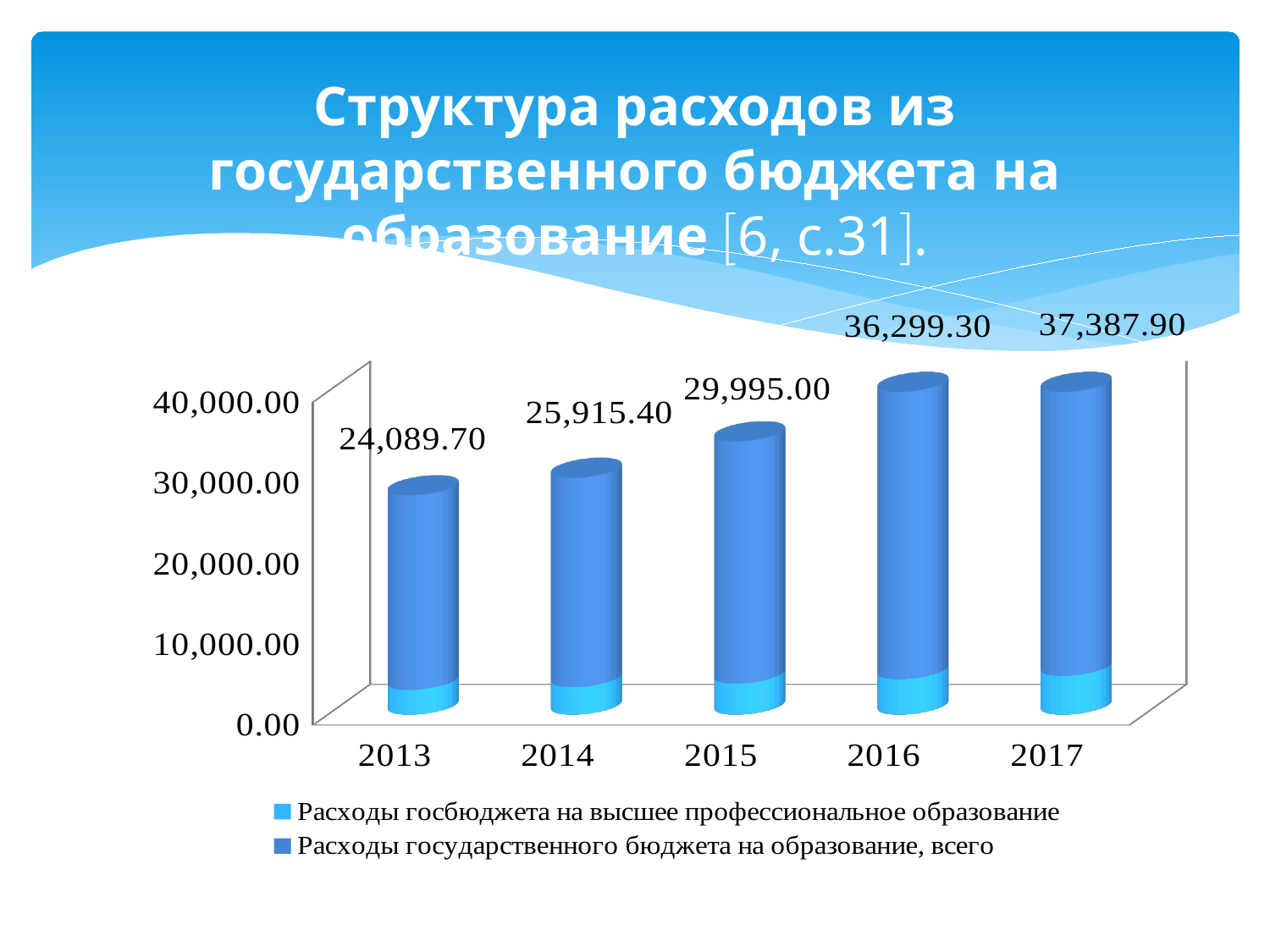
What is the labelled value for 2017 for the series 'Расходы государственного бюджета на образование, всего'? 37,387.90 Which year has the larger labelled value for 'Расходы государственного бюджета на образование, всего': 2015 or 2016? 2016 Do the labelled values for 'Расходы государственного бюджета на образование, всего' rise or fall from 2013 to 2017? rise What is the difference between the labelled values for 2015 and 2014 for 'Расходы государственного бюджета на образование, всего'? 4,079.60 How many years are shown on the x axis of the chart? 5 Which year has the lowest labelled value for 'Расходы государственного бюджета на образование, всего'? 2013 How many series does the chart legend list? 2 What is the labelled value for 2013 for the series 'Расходы государственного бюджета на образование, всего'? 24,089.70 What is the difference between the labelled values for 2017 and 2016 for 'Расходы государственного бюджета на образование, всего'? 1,088.60 Is the value for 2017 for 'Расходы госбюджета на высшее профессиональное образование' greater or less than 10,000.00? less What is the labelled value for 2015 for the series 'Расходы государственного бюджета на образование, всего'? 29,995.00 Which year has the highest labelled value for 'Расходы государственного бюджета на образование, всего'? 2017